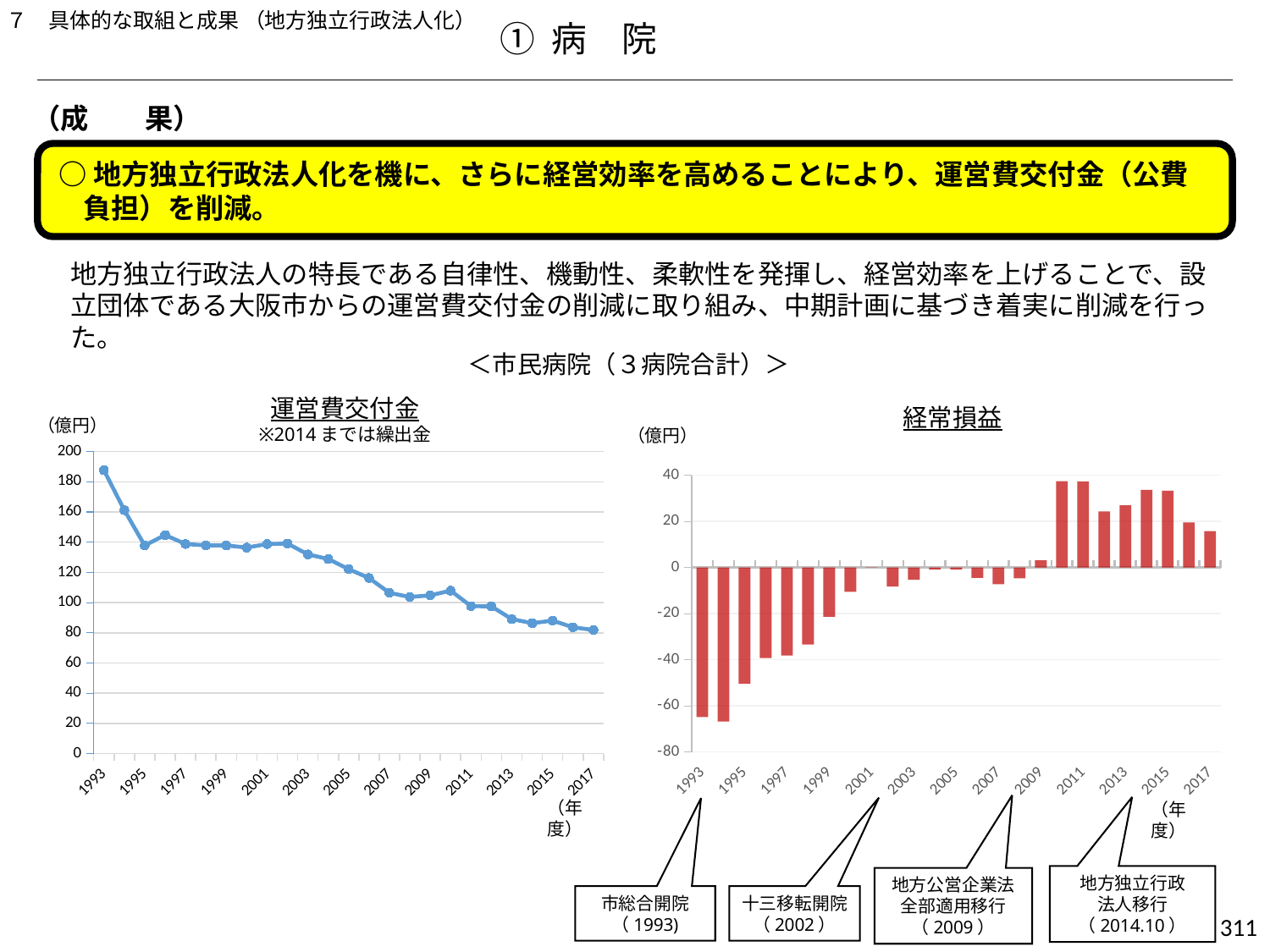
In the 運営費交付金 chart, do the values generally rise or fall from 1993 to 2017? fall In the 運営費交付金 chart, is the value for 1993 greater or less than 180? greater In the 経常損益 chart, which is larger, the value for 2010 or the value for 2017? 2010 In the 運営費交付金 chart, which year has the highest value? 1993 What kind of chart is the 経常損益 chart on the right? bar chart In the 経常損益 chart, is the value for 1993 greater or less than -60? less In the 運営費交付金 chart, is the value for 2017 greater or less than 100? less What kind of chart is the 運営費交付金 chart on the left? line chart What unit is shown on the vertical axis of the 経常損益 chart? 億円 In the 経常損益 chart, which is larger, the value for 1993 or the value for 2005? 2005